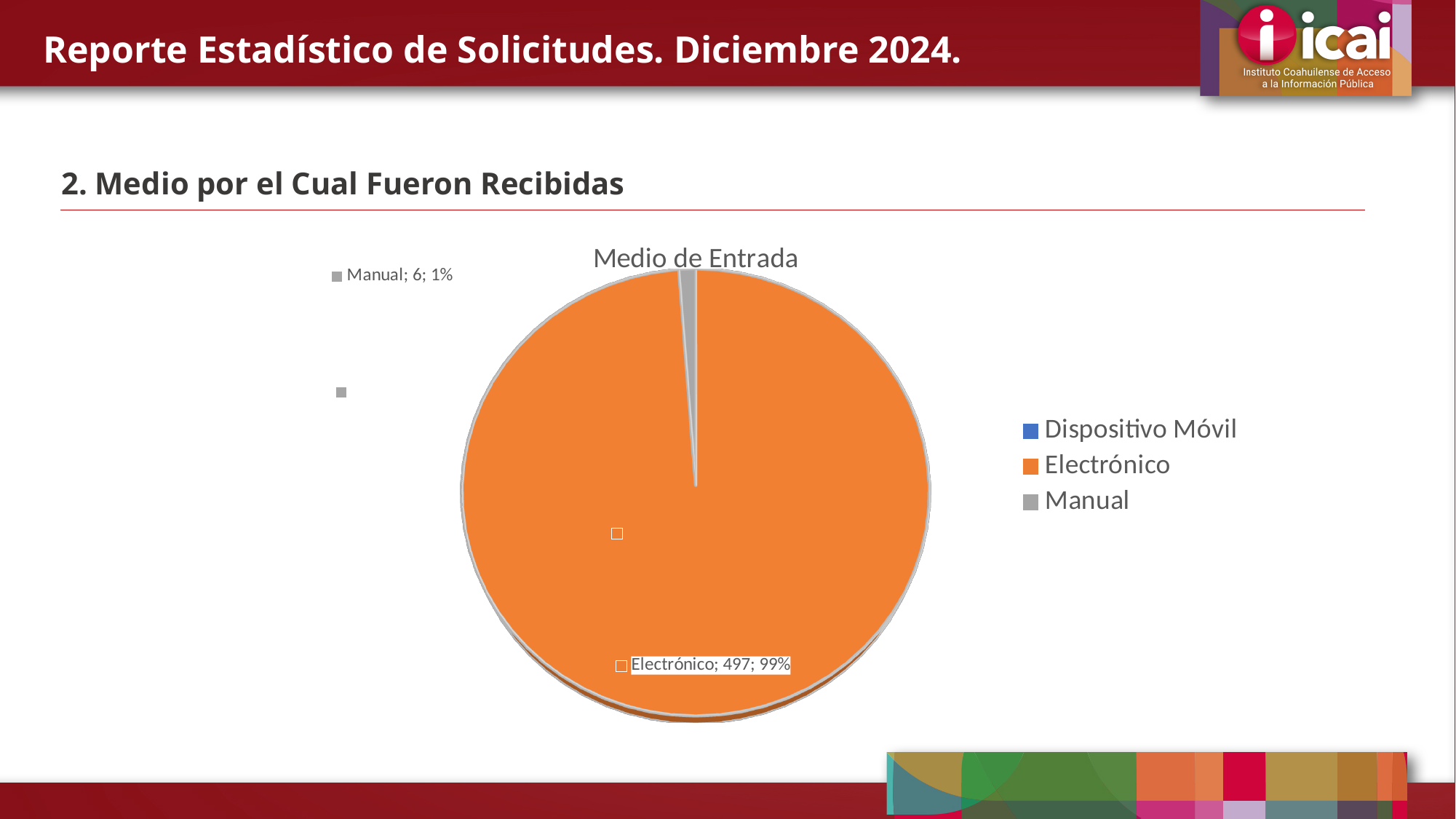
What kind of chart is shown on the slide? Pie chart What is the difference between the Electrónico and Manual values in the Medio de Entrada chart? 491 What share of the Medio de Entrada pie does Electrónico represent? 99% What is the title of the chart on the slide? Medio de Entrada Which category has the largest slice in the Medio de Entrada pie chart? Electrónico What is the value for Manual in the Medio de Entrada pie chart? 6 How many entries does the legend of the Medio de Entrada chart list? 3 Which is larger in the Medio de Entrada chart, Electrónico or Manual? Electrónico What share of the Medio de Entrada pie does Manual represent? 1% What colour is the Electrónico slice in the Medio de Entrada pie chart? Orange What is the value for Electrónico in the Medio de Entrada pie chart? 497